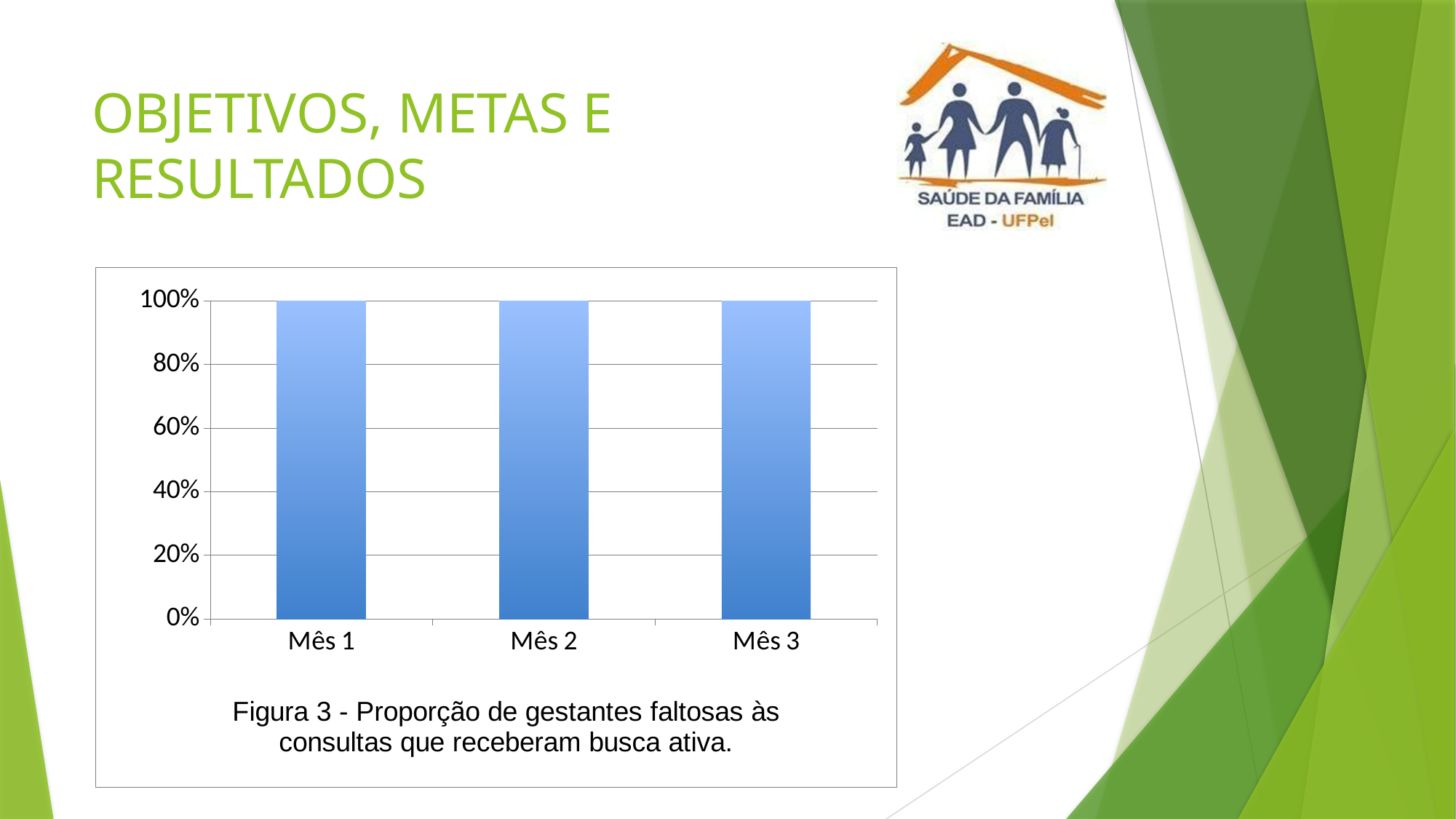
What is the value for Mês 1? 100% What is the value for Mês 2? 100% What is the figure number given in the chart caption? Figura 3 What is the difference between the values for Mês 1 and Mês 3? 0% How many categories are shown on the x axis? 3 What kind of chart is shown on the slide? bar chart Is the value for Mês 2 greater or less than 80%? greater What is the highest value shown on the y axis? 100% What is the value for Mês 3? 100% Do the values rise, fall or stay the same from Mês 1 to Mês 3? stay the same Is the value for Mês 1 greater or less than 60%? greater